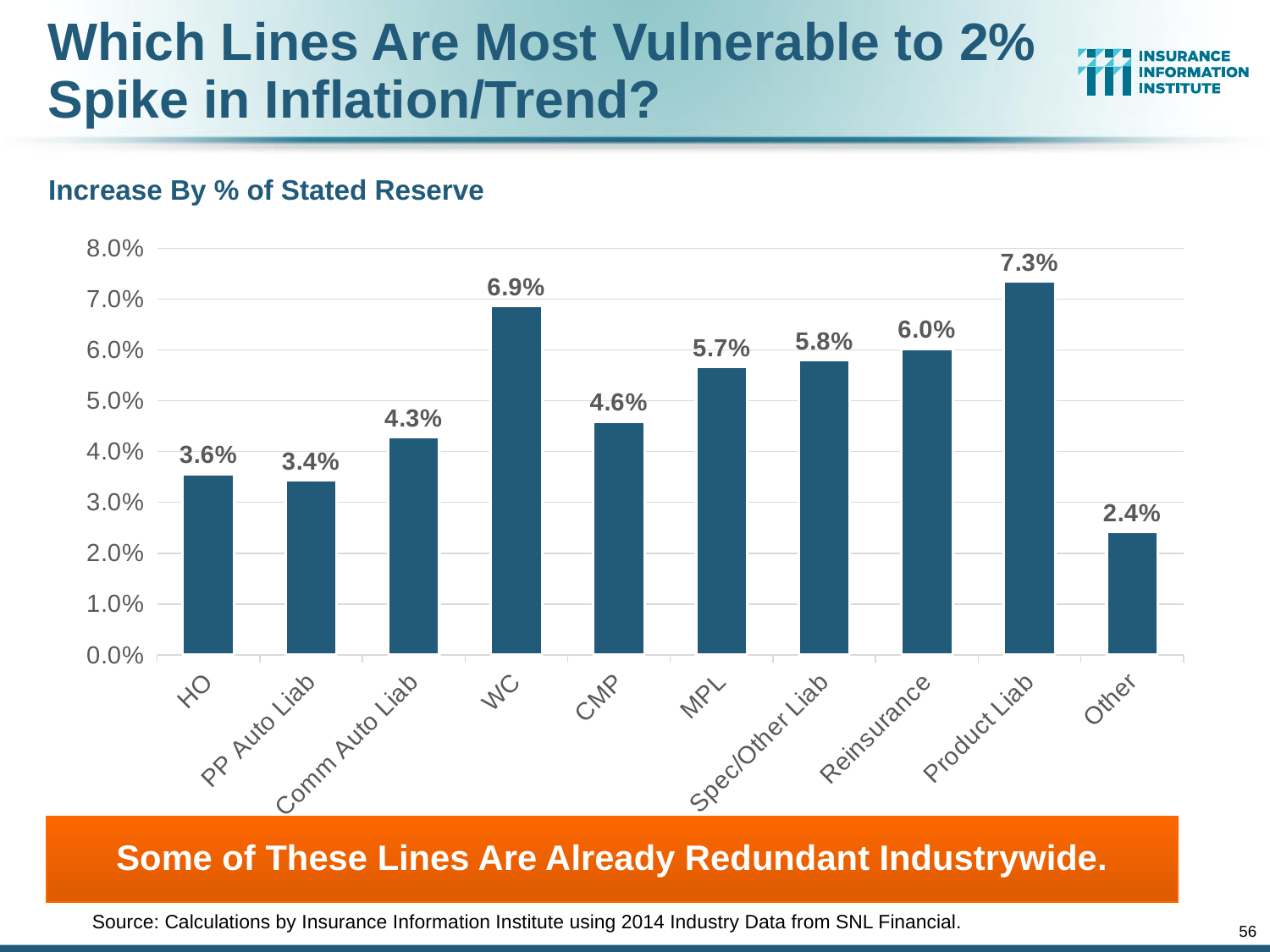
Which is larger, the value for HO or the value for PP Auto Liab? HO What is the difference between the values for Product Liab and Other? 4.9% Is the value for MPL greater or less than 5.0%? greater What is the value for Reinsurance? 6.0% What is the value for Comm Auto Liab? 4.3% What kind of chart is shown on the slide? bar chart Which category has the lowest value? Other What is the difference between the values for WC and CMP? 2.3% Which category has the highest value? Product Liab How many categories are shown on the x axis? 10 What is the chart's title? Increase By % of Stated Reserve What is the value for WC? 6.9%